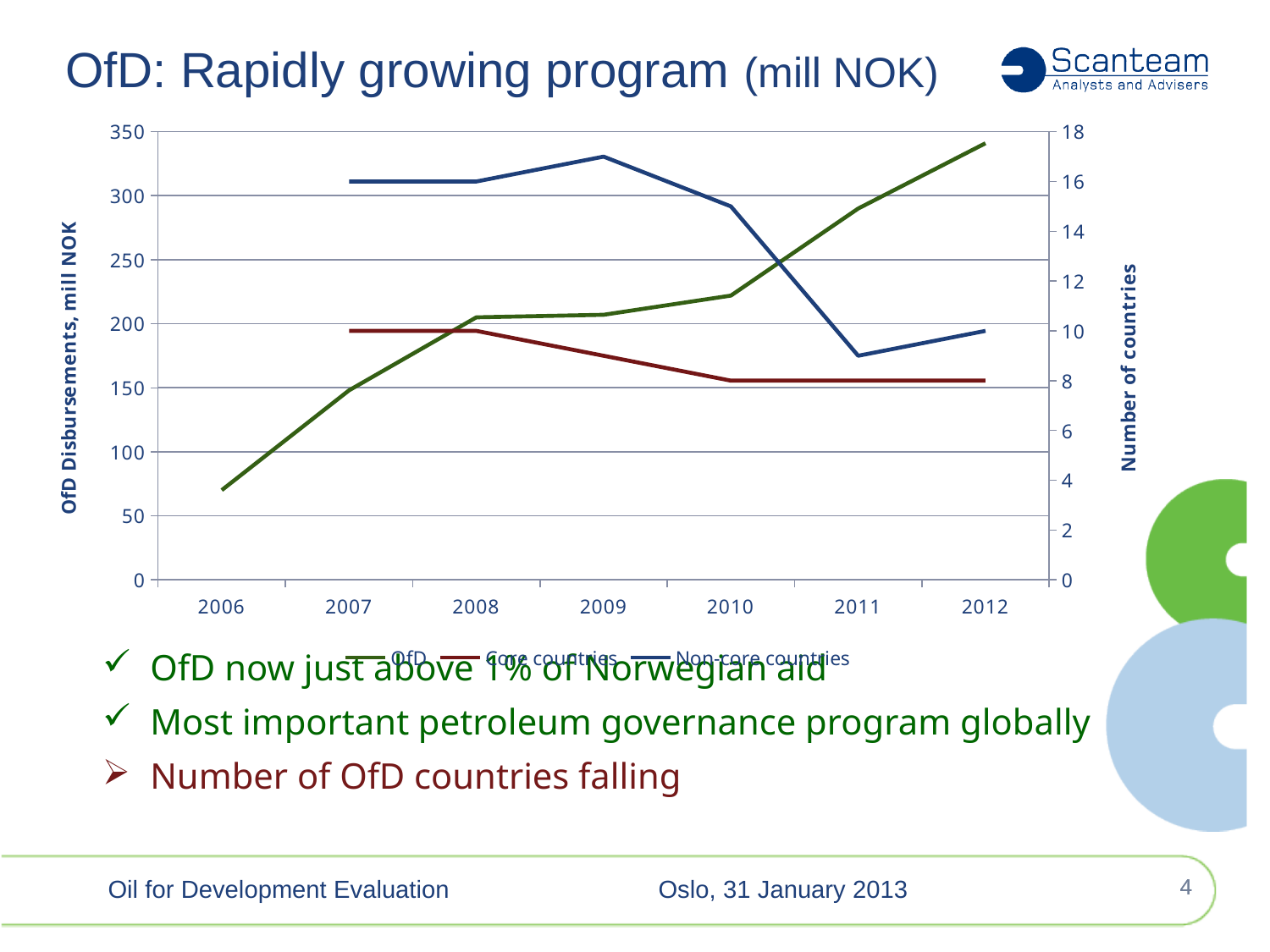
In 2009, which is larger: the number of core countries or the number of non-core countries? Non-core countries How many years are shown on the x axis of the chart? 7 What kind of chart is shown on the slide? line chart What is the title of the right-hand vertical axis? Number of countries Is the OfD value for 2006 greater or less than 100? less In which year is the OfD disbursement lowest? 2006 Does the OfD series rise or fall from 2006 to 2012? rise How many core countries are shown for 2012? 8 How many series does the chart's legend list? 3 In which year is the OfD disbursement highest? 2012 Is the OfD value for 2012 greater or less than 300? greater How many non-core countries are shown for 2008? 16